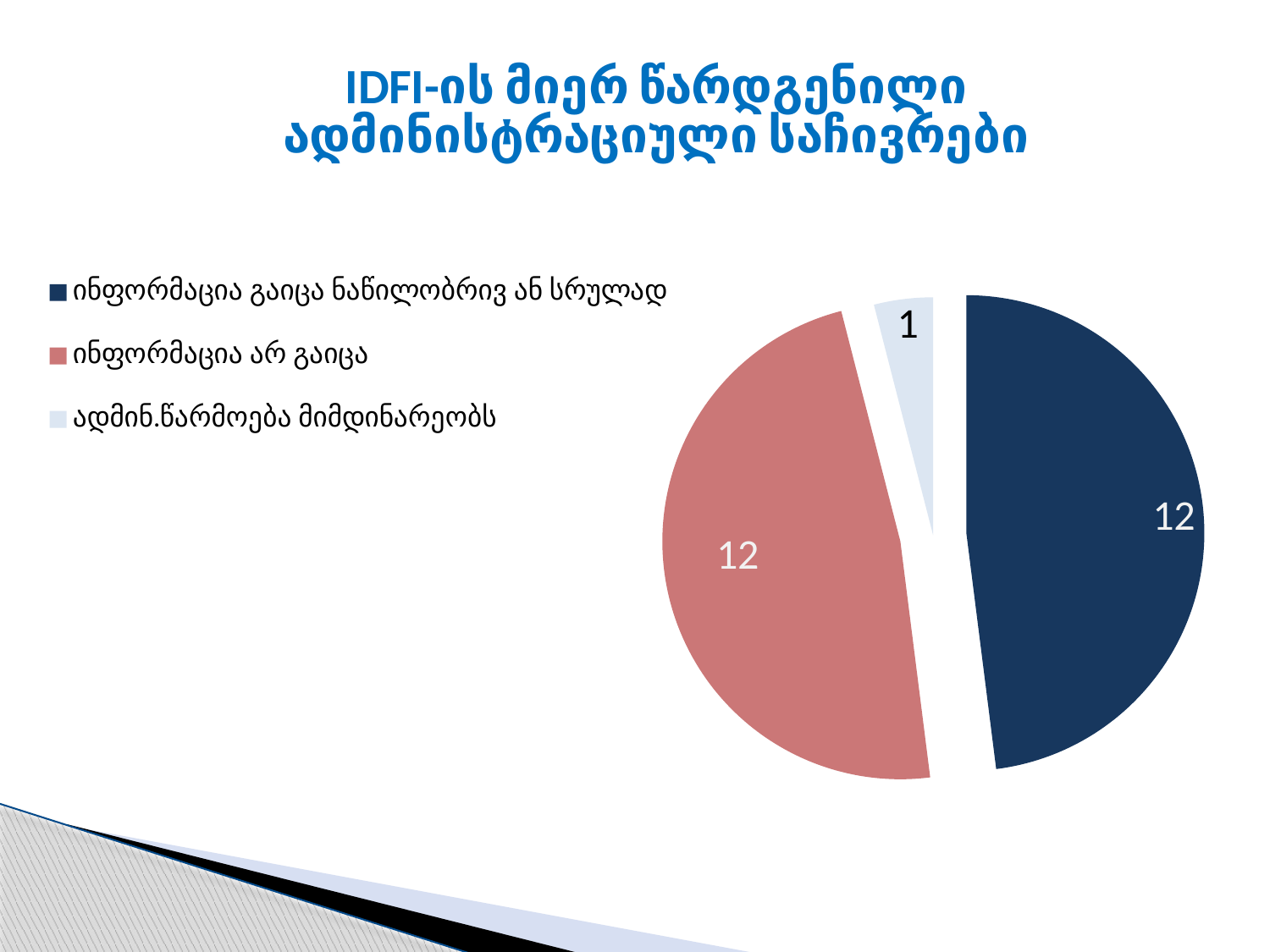
How many slices does the pie chart have? 3 What is the total of all the values shown in the pie chart? 25 Which is larger: the value for "ინფორმაცია გაიცა ნაწილობრივ ან სრულად" or the value for "ადმინ.წარმოება მიმდინარეობს"? ინფორმაცია გაიცა ნაწილობრივ ან სრულად What kind of chart is shown on the slide? Pie chart What value is shown for the slice "ინფორმაცია არ გაიცა"? 12 Which category has the smallest slice in the pie chart? ადმინ.წარმოება მიმდინარეობს What is the difference between the values for "ინფორმაცია არ გაიცა" and "ადმინ.წარმოება მიმდინარეობს"? 11 What value is shown for the slice "ინფორმაცია გაიცა ნაწილობრივ ან სრულად"? 12 What value is shown for the slice "ადმინ.წარმოება მიმდინარეობს"? 1 What colour is the slice for "ინფორმაცია არ გაიცა"? Red What share of the pie does the slice "ადმინ.წარმოება მიმდინარეობს" represent? 4% How many entries does the legend list? 3